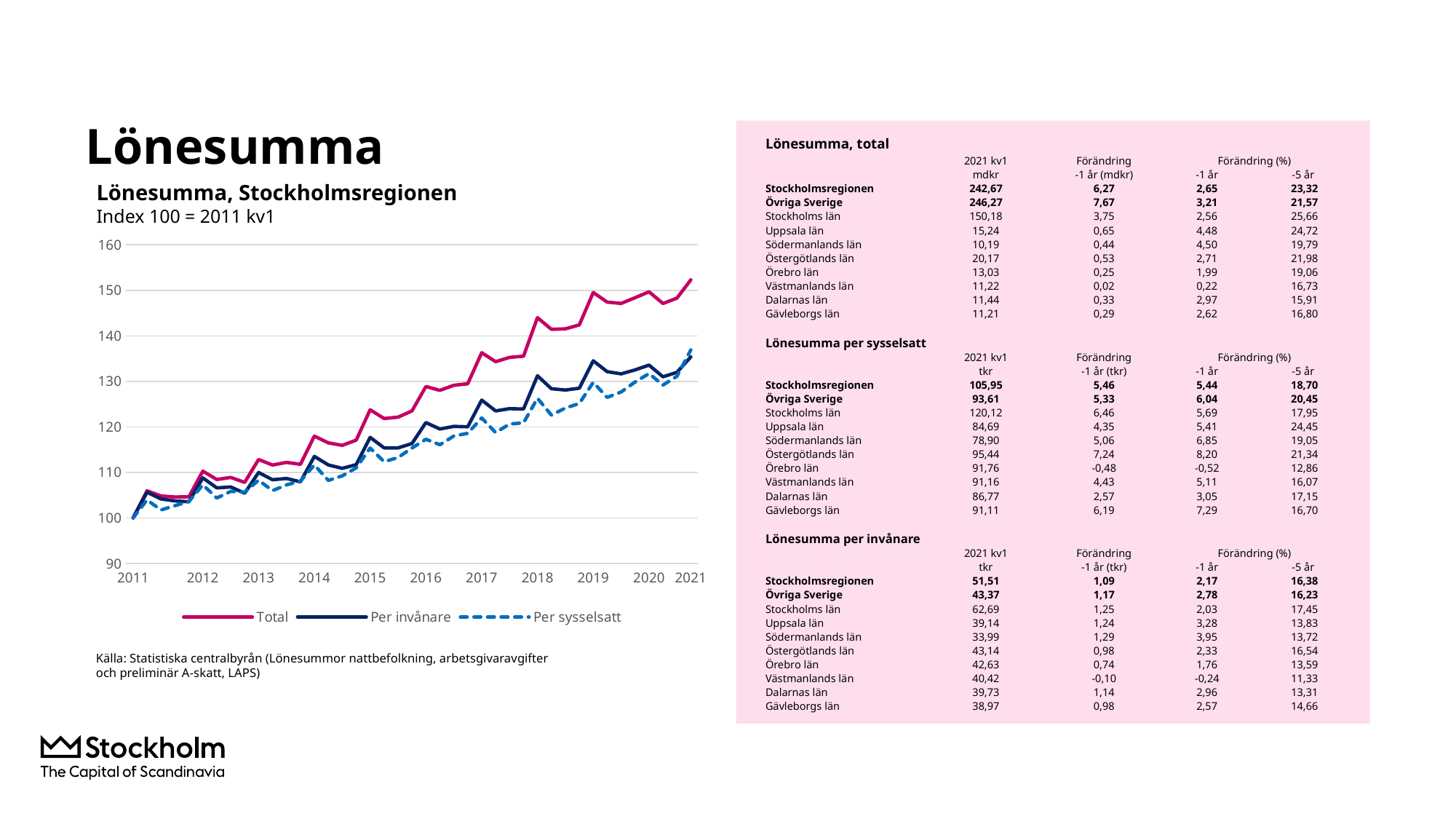
Is the value for Per invånare in 2017 greater or less than 130? less Is the value for Total in 2015 greater or less than 120? greater Which series has the highest value at the end of 2021? Total Which series is drawn with a dashed line in the chart? Per sysselsatt Does the Total series rise or fall from 2011 to 2021? rise Which series has the lowest value in 2019? Per sysselsatt What is the title of the chart? Lönesumma, Stockholmsregionen Is the value for Total in 2019 greater or less than 140? greater Which is larger in 2019, Total or Per sysselsatt? Total What is the index value of all series at 2011 kv1? 100 What kind of chart is shown on the slide? line chart How many series does the chart legend list? 3